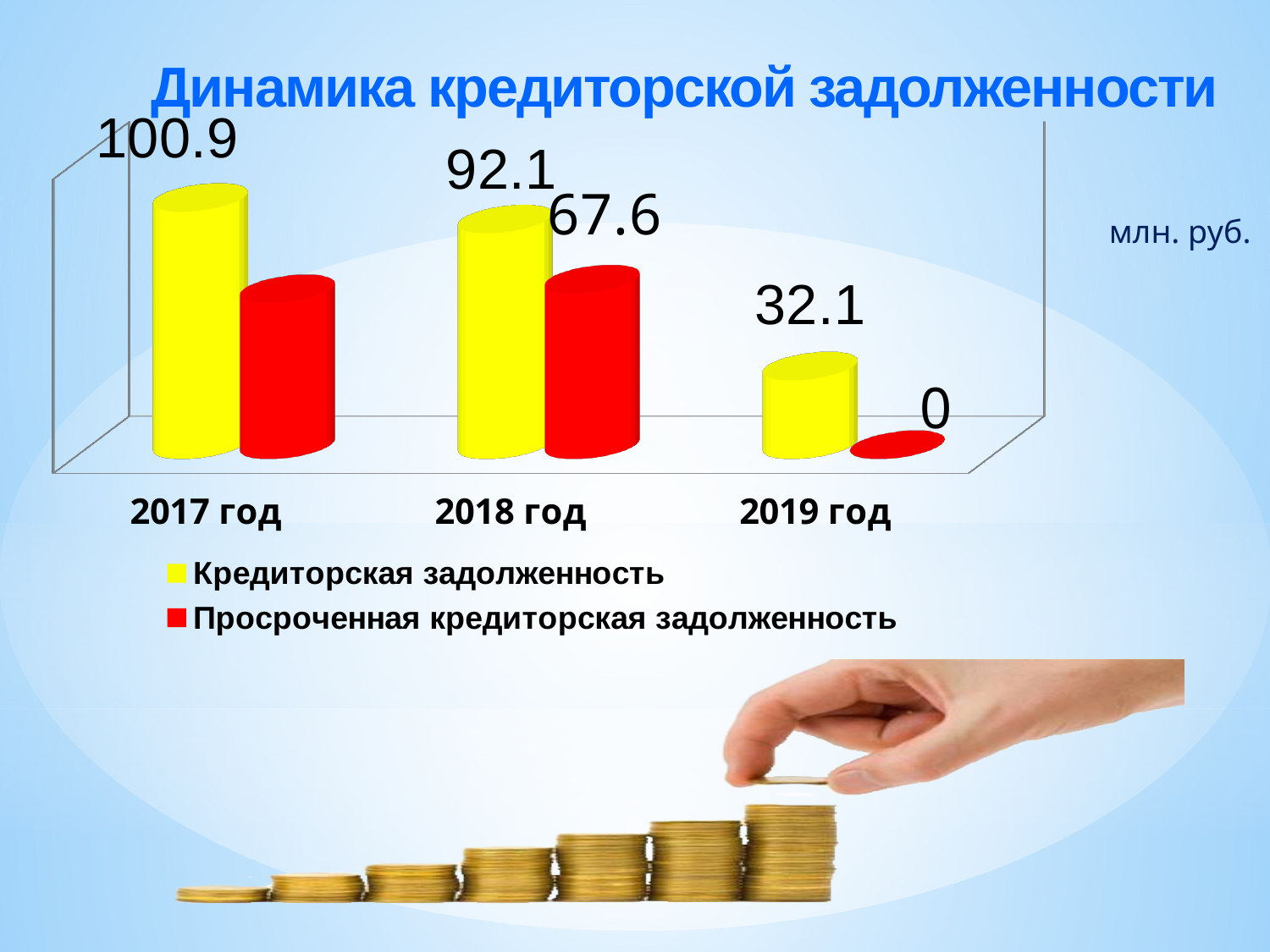
By how much did Кредиторская задолженность fall from 2017 год to 2019 год? 68.8 What is the value of Кредиторская задолженность for 2018 год? 92.1 Which year has the lowest Кредиторская задолженность? 2019 год How many series does the legend list? 2 What is the value of Просроченная кредиторская задолженность for 2019 год? 0 What is the value of Кредиторская задолженность for 2019 год? 32.1 What is the value of Кредиторская задолженность for 2017 год? 100.9 Which year has the highest Кредиторская задолженность? 2017 год How many years (categories) are shown on the chart? 3 What is the difference between Кредиторская задолженность and Просроченная кредиторская задолженность in 2018 год? 24.5 What is the value of Просроченная кредиторская задолженность for 2018 год? 67.6 Does Кредиторская задолженность rise or fall from 2017 год to 2019 год? fall